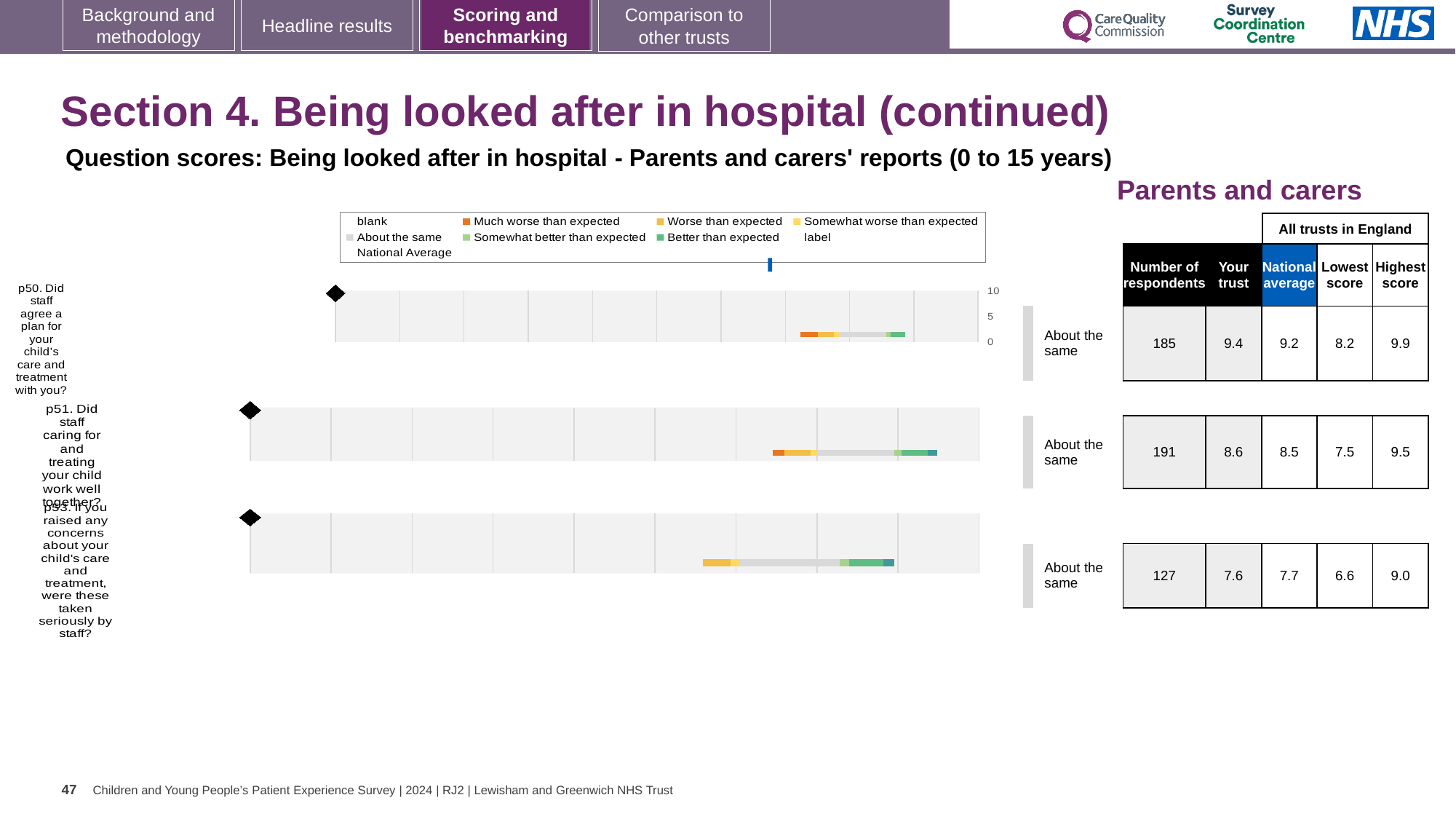
What benchmark category is shown next to the chart for p53? About the same Which question has the highest 'Your trust' score on this slide? p50 Which question has the lowest number of respondents on this slide? p53 For p50, which is larger: the 'Your trust' score or the national average? Your trust How many respondents answered p53 (If you raised any concerns about your child's care and treatment, were these taken seriously by staff?)? 127 For p51, what is the difference between the highest score and the lowest score among all trusts in England? 2.0 What is the national average score for p51 (Did staff caring for and treating your child work well together?)? 8.5 What is the 'Your trust' score for p50 (Did staff agree a plan for your child's care and treatment with you?)? 9.4 What kind of chart is used to show the question scores on this slide? bar chart What is the lowest score among all trusts in England for p50? 8.2 How many survey questions are plotted on this slide? 3 What colour does the legend use for 'Much worse than expected'? orange